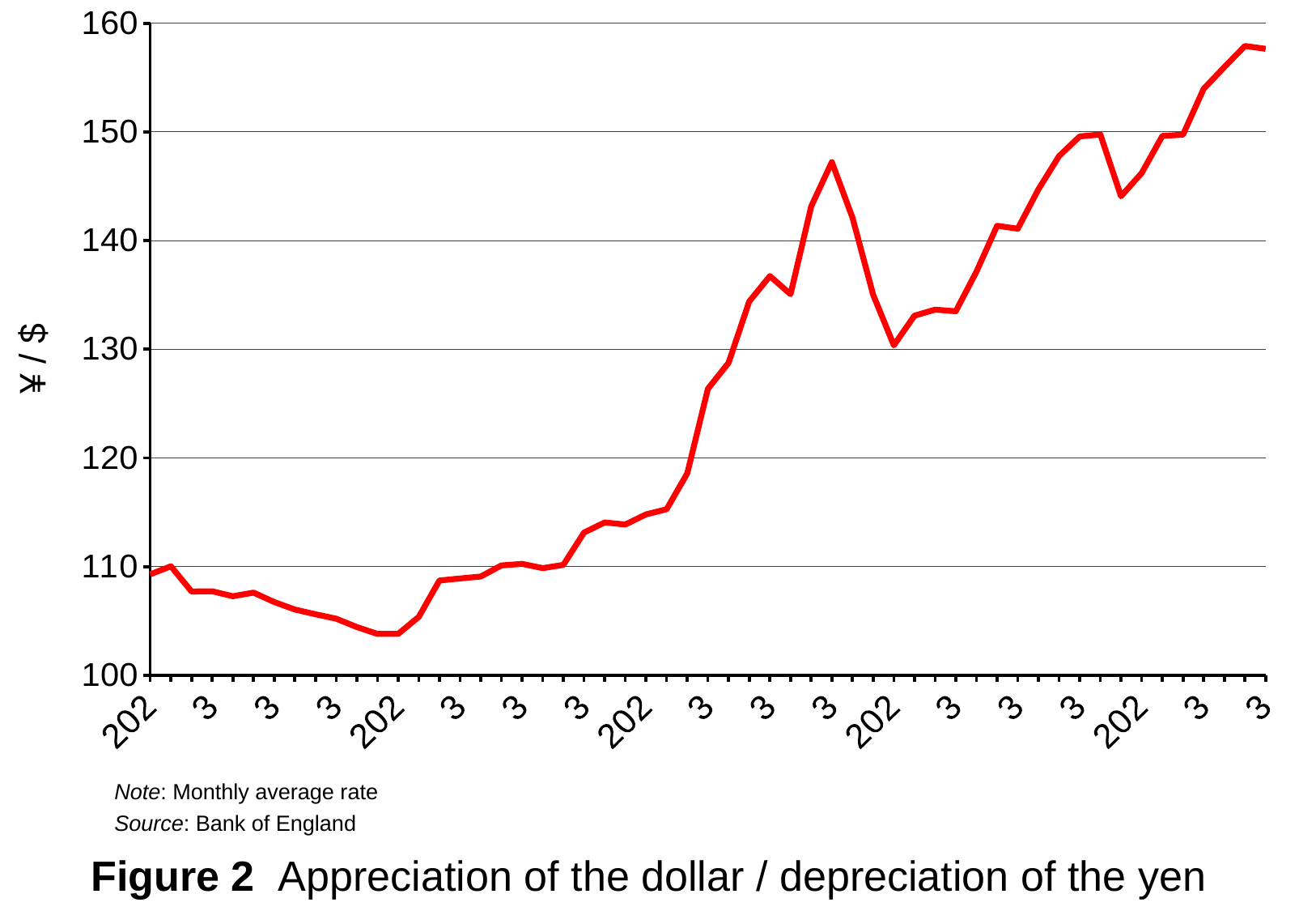
What kind of chart is shown on the slide? Line chart What is the figure caption shown below the chart? Figure 2 Appreciation of the dollar / depreciation of the yen What is the label on the y axis? ¥ / $ Is the highest point on the line greater or less than 150? greater Is the lowest point on the line greater or less than 110? less Is the value at the end of the series higher or lower than the value at the start? Higher Is the value at the right-hand end of the line greater or less than 150? greater Overall, do the values rise or fall from left to right along the x axis? Rise